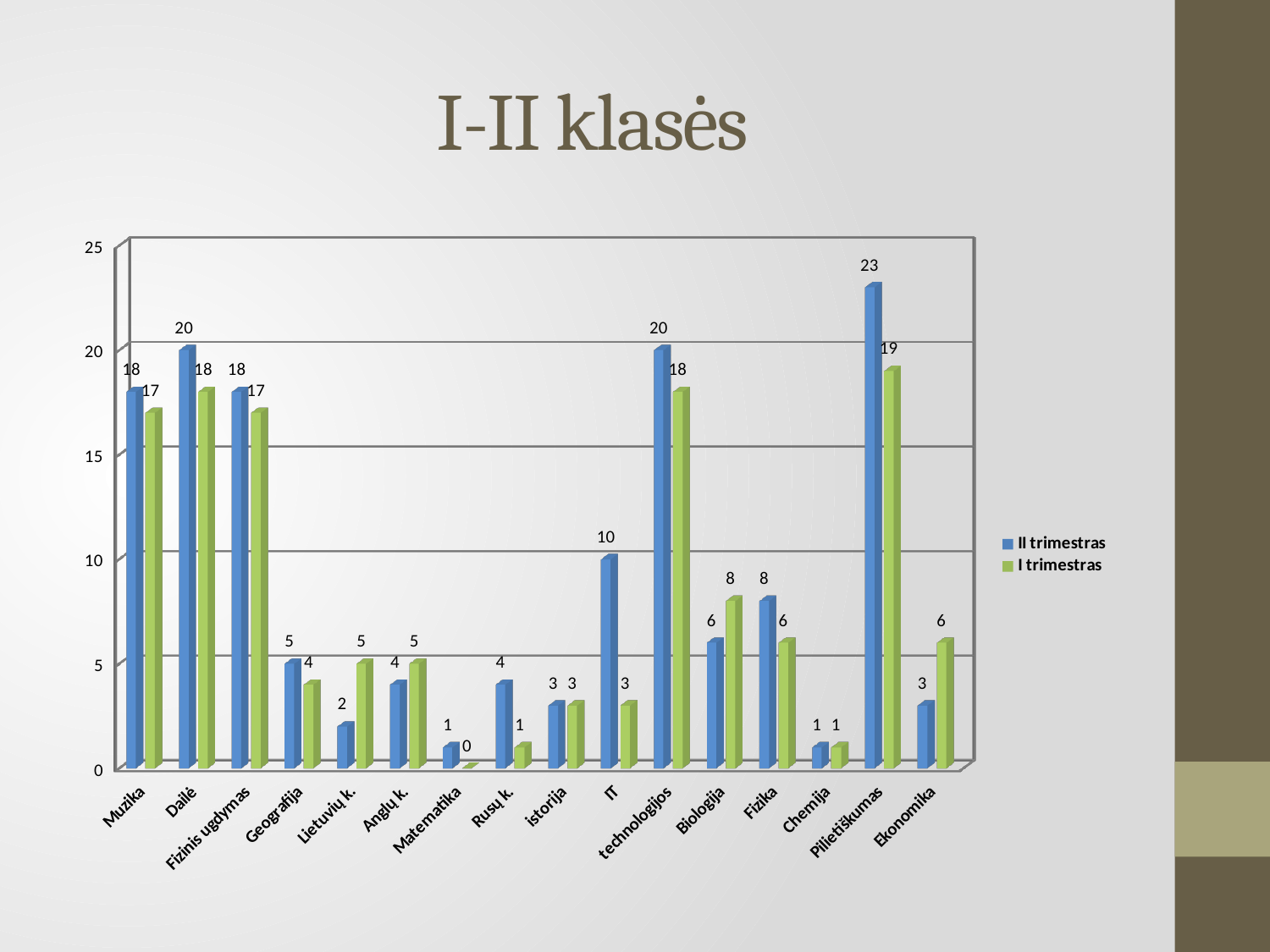
What is the value for IT in the II trimestras series? 10 What kind of chart is shown on the slide? Bar chart How many series does the legend list? 2 Which category has the highest value in the II trimestras series? Pilietiškumas Which is larger for Biologija: the II trimestras value or the I trimestras value? I trimestras What is the value for Pilietiškumas in the II trimestras series? 23 What is the difference between the II trimestras and I trimestras values for IT? 7 Which category has the lowest value in the I trimestras series? Matematika What is the value for Ekonomika in the I trimestras series? 6 What is the difference between the II trimestras and I trimestras values for Pilietiškumas? 4 What is the title of the slide? I-II klasės How many categories are shown on the x axis? 16